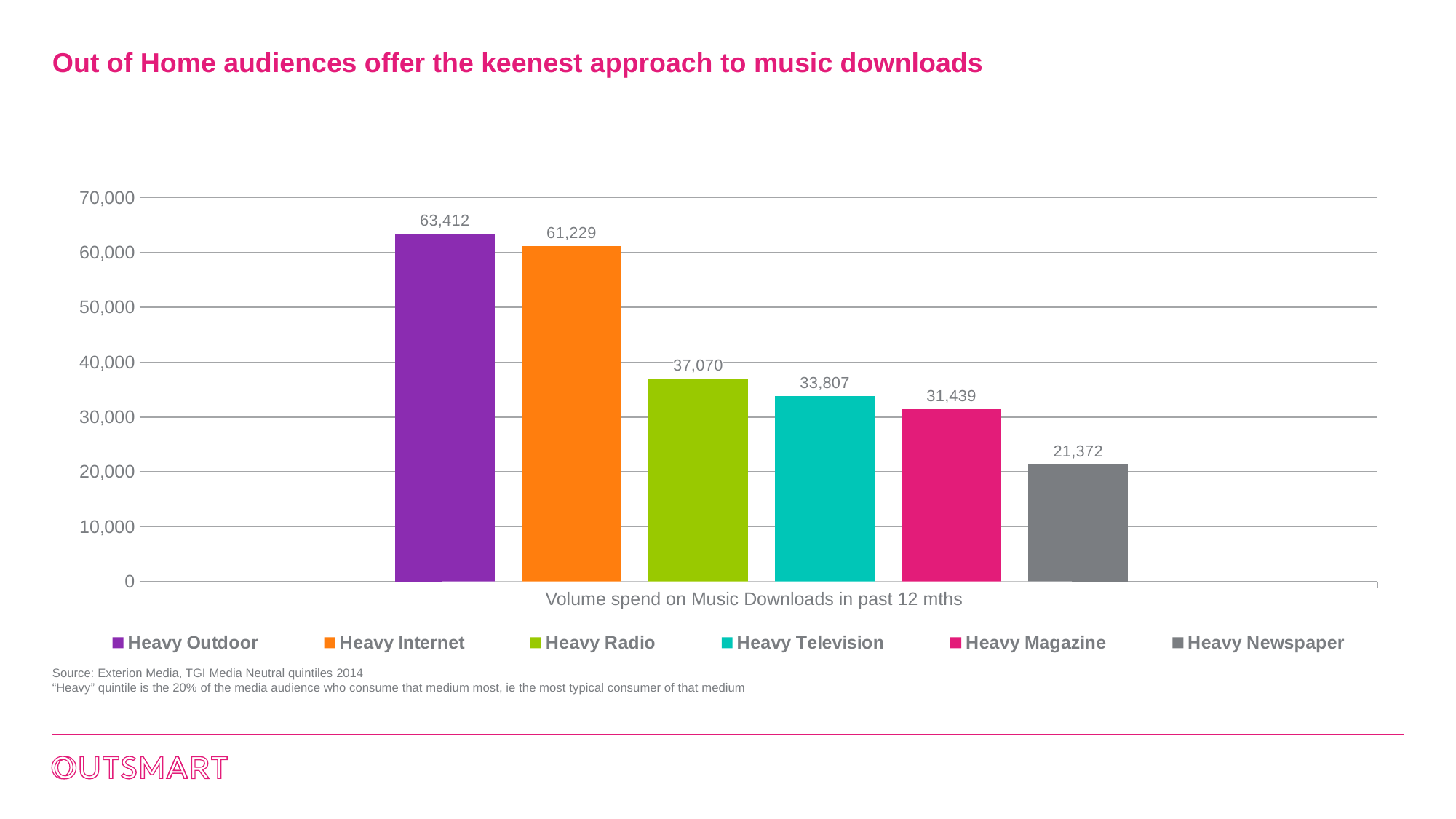
Which series has the lowest value? Heavy Newspaper What is the value for Heavy Newspaper? 21,372 Which is larger, the value for Heavy Radio or the value for Heavy Magazine? Heavy Radio What is the value for Heavy Television? 33,807 What is the value for Heavy Outdoor? 63,412 Which series has the highest value? Heavy Outdoor Is the value for Heavy Magazine greater or less than 30,000? greater How many series does the legend list? 6 What kind of chart is shown on the slide? Bar chart What is the difference between the values for Heavy Outdoor and Heavy Internet? 2,183 What is the label on the x axis of the chart? Volume spend on Music Downloads in past 12 mths What is the difference between the values for Heavy Radio and Heavy Newspaper? 15,698